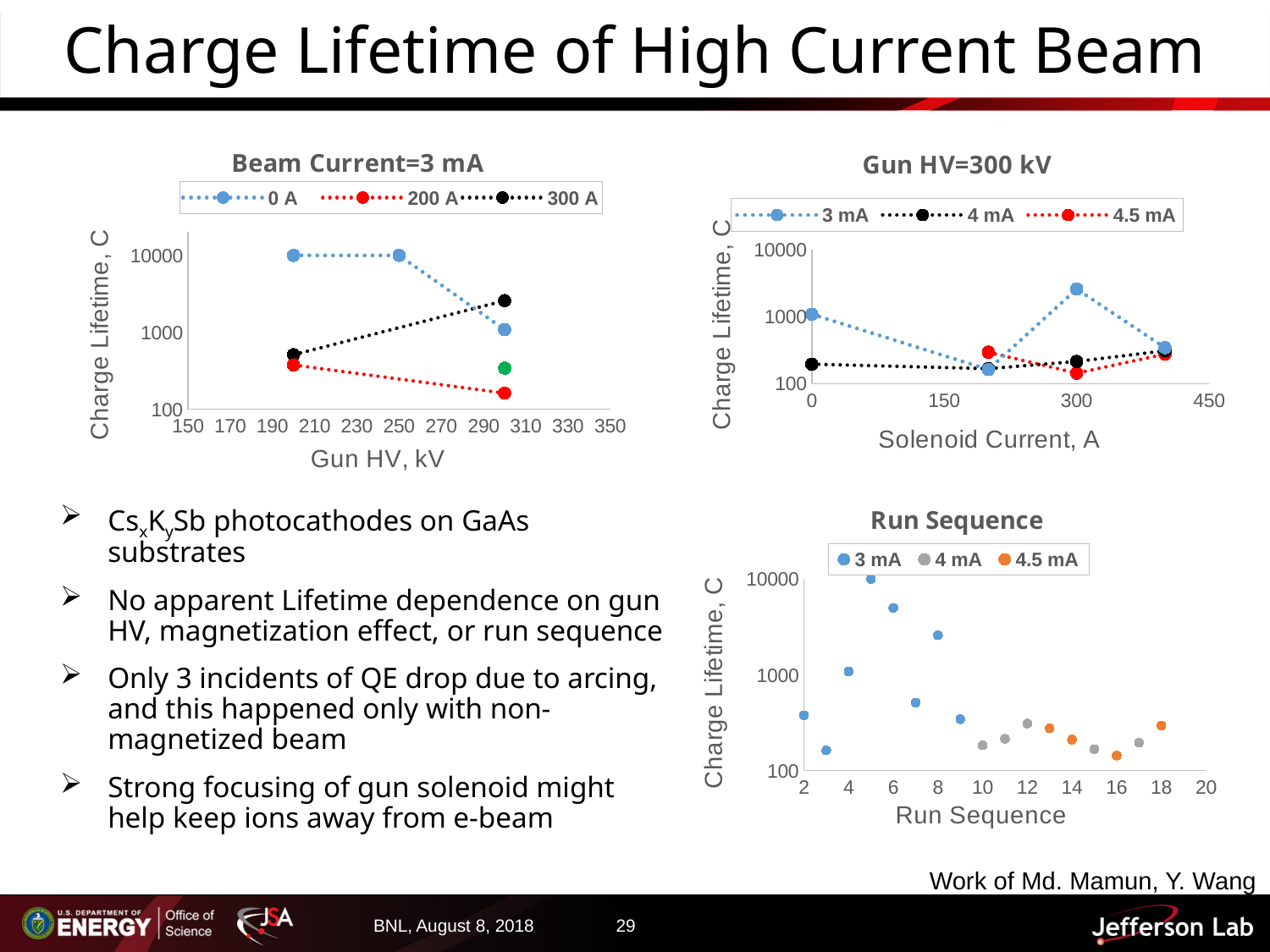
In the "Beam Current=3 mA" chart, how many points are plotted for the 0 A series? 3 In the "Beam Current=3 mA" chart, at 300 kV, which series has the larger value: 300 A or 200 A? 300 A How many series does the legend of the "Beam Current=3 mA" chart list? 3 What is the x-axis title of the "Gun HV=300 kV" chart? Solenoid Current, A In the "Beam Current=3 mA" chart, does the 200 A series rise or fall from 200 kV to 300 kV? fall How many series does the legend of the "Gun HV=300 kV" chart list? 3 What kind of chart is the "Beam Current=3 mA" chart? scatter chart In the "Run Sequence" chart, at which run sequence number is the highest charge lifetime plotted? 5 In the "Gun HV=300 kV" chart, is the value for the 3 mA series at 300 A greater or less than 1000? greater In the "Beam Current=3 mA" chart, is the value for the 0 A series at 250 kV greater or less than 1000? greater In the "Gun HV=300 kV" chart, which series has the highest value at a solenoid current of 0 A? 3 mA In the "Beam Current=3 mA" chart, is the value for the 200 A series at 300 kV greater or less than 1000? less